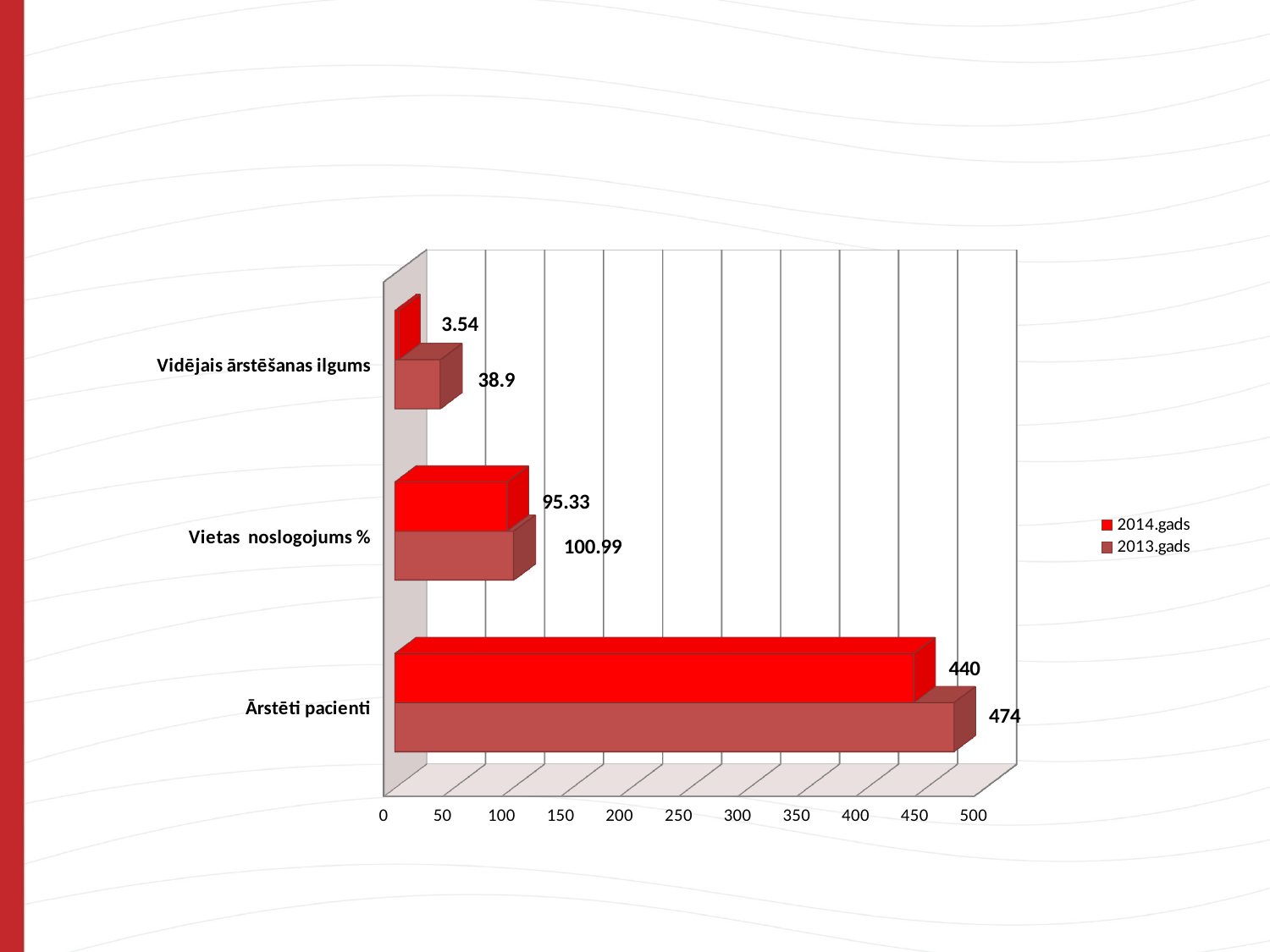
What kind of chart is shown on the slide? Bar chart What is the value for Vietas noslogojums % in the 2013.gads series? 100.99 What is the value for Ārstēti pacienti in the 2014.gads series? 440 Which category has the lowest value in the 2014.gads series? Vidējais ārstēšanas ilgums What is the value for Vidējais ārstēšanas ilgums in the 2013.gads series? 38.9 How many categories are shown on the chart? 3 How many series does the legend list? 2 For Vietas noslogojums %, which series has the larger value, 2014.gads or 2013.gads? 2013.gads Which category has the highest value in the 2013.gads series? Ārstēti pacienti What is the difference between the 2013.gads and 2014.gads values for Ārstēti pacienti? 34 What is the value for Ārstēti pacienti in the 2013.gads series? 474 What is the value for Vidējais ārstēšanas ilgums in the 2014.gads series? 3.54